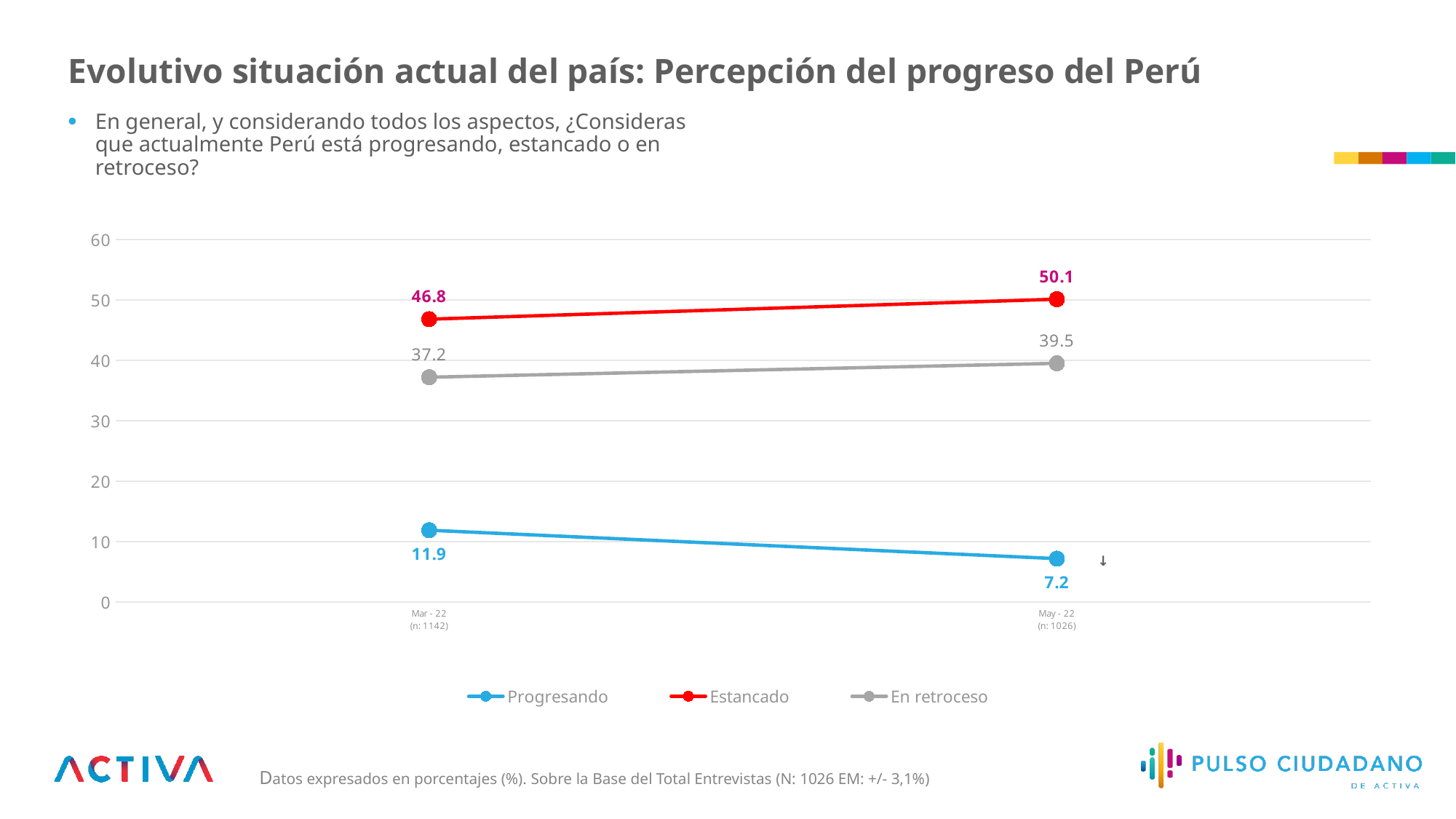
Which series has the highest value in May - 22? Estancado What is the value for Estancado in May - 22? 50.1 How many series does the legend list? 3 Which is larger: Progresando in Mar - 22 or Progresando in May - 22? Mar - 22 Which series has the lowest value in Mar - 22? Progresando What is the difference between Estancado and En retroceso in Mar - 22? 9.6 What kind of chart is shown on the slide? Line chart What is the value for Progresando in Mar - 22? 11.9 Does the Progresando series rise or fall from Mar - 22 to May - 22? Fall What is the difference between the Estancado values in May - 22 and Mar - 22? 3.3 What is the value for Estancado in Mar - 22? 46.8 What is the value for En retroceso in May - 22? 39.5